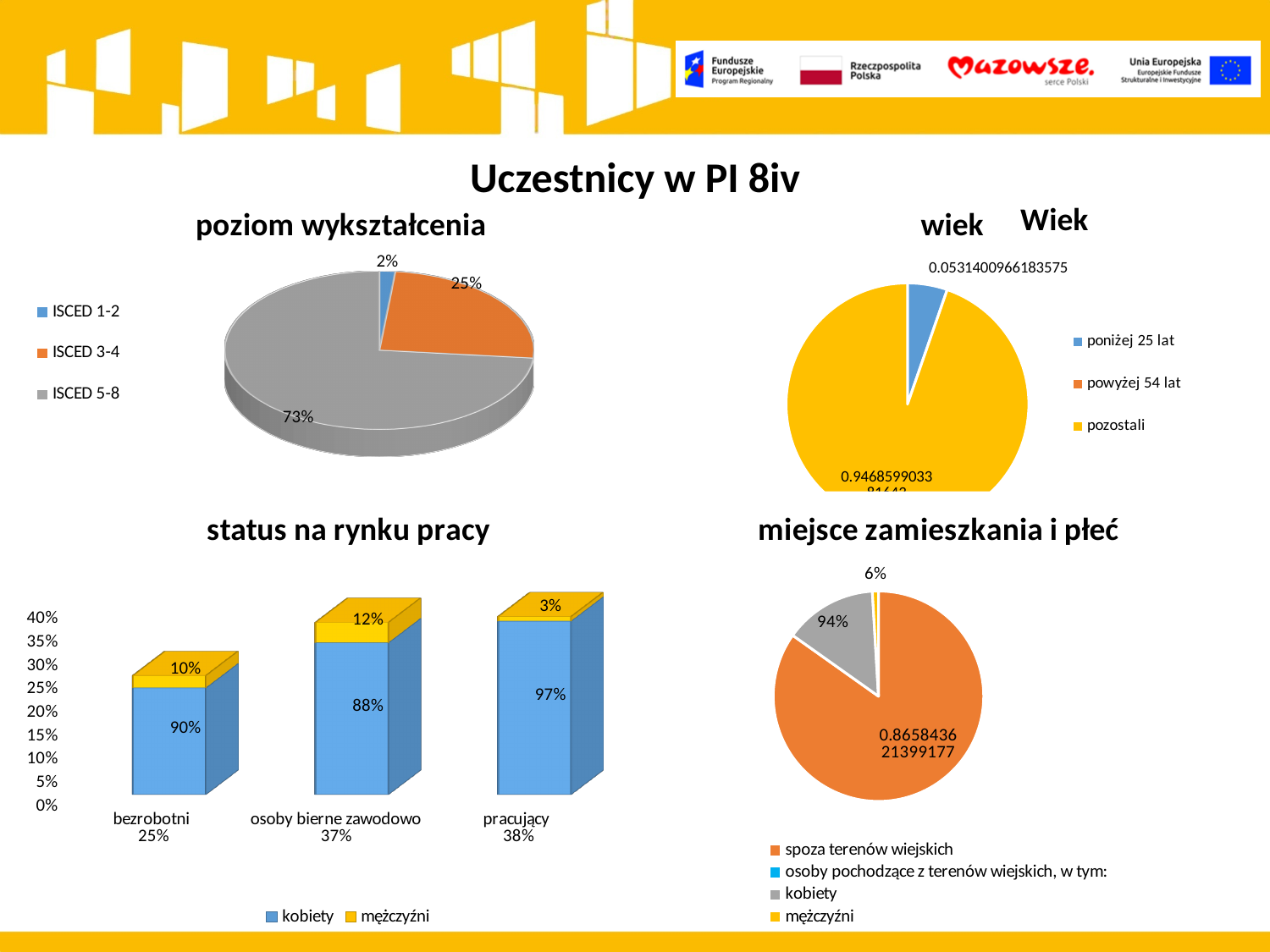
In the 'poziom wykształcenia' chart, what is the difference between the ISCED 5-8 and ISCED 3-4 shares? 48% What kind of chart is the 'wiek' chart? pie chart How many categories are shown on the x axis of the 'status na rynku pracy' chart? 3 In the 'status na rynku pracy' chart, which category has the highest value for mężczyźni? osoby bierne zawodowo In the 'poziom wykształcenia' chart, what percentage is shown for ISCED 3-4? 25% In the 'miejsce zamieszkania i płeć' chart, what percentage is shown on the gray slice (kobiety)? 94% In the 'status na rynku pracy' chart, what is the value for mężczyźni in the 'osoby bierne zawodowo' category? 12% In the 'poziom wykształcenia' chart, what percentage is shown for ISCED 5-8? 73% In the 'status na rynku pracy' chart, what is the value for kobiety in the 'pracujący' category? 97% In the 'poziom wykształcenia' chart, which category has the smallest share? ISCED 1-2 How many entries does the legend of the 'wiek' chart list? 3 In the 'wiek' chart, what value is labelled on the blue slice (poniżej 25 lat)? 0.0531400966183575